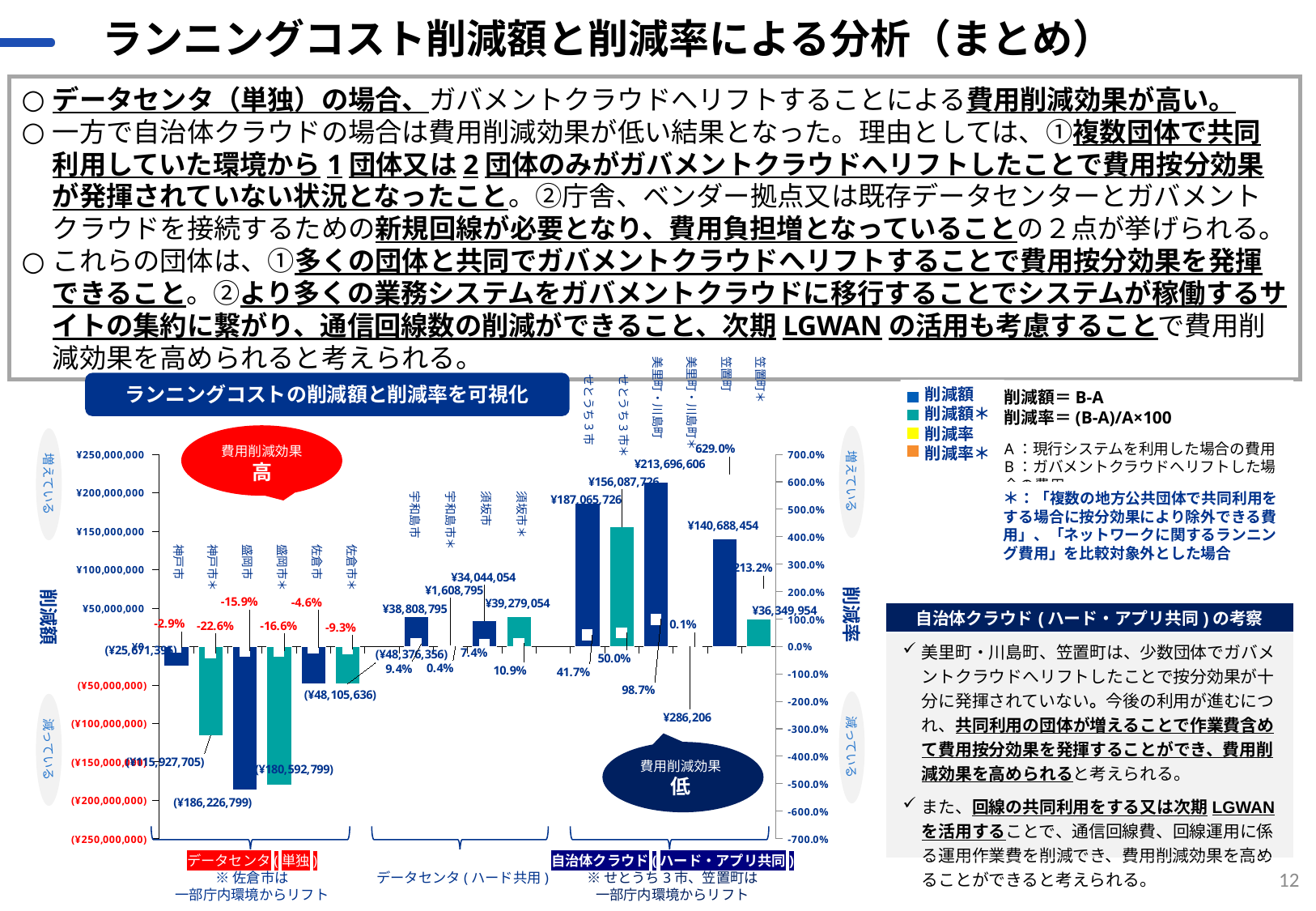
What kind of chart is shown under the heading 「ランニングコストの削減額と削減率を可視化」? bar chart What are the four legend entries of the chart? 削減額, 削減額＊, 削減率, 削減率＊ How many categories (municipality labels) are plotted along the x axis of the chart? 16 What is the 削減額 value labelled for 笠置町? ¥140,688,454 How many series does the chart legend list? 4 Which category has the lowest (most negative) 削減額 bar in the chart? 盛岡市 Which has the larger 削減額: せとうち3市 or 笠置町? せとうち3市 Is the 削減額 value for 宇和島市 greater or less than ¥100,000,000? less What is the difference between the 削減額 of 美里町・川島町 (¥213,696,606) and 笠置町 (¥140,688,454)? ¥73,008,152 What is the 削減額 value labelled for 美里町・川島町? ¥213,696,606 What is the 削減率 value labelled for 神戸市＊? -22.6% Which category has the highest 削減額 bar in the chart? 美里町・川島町